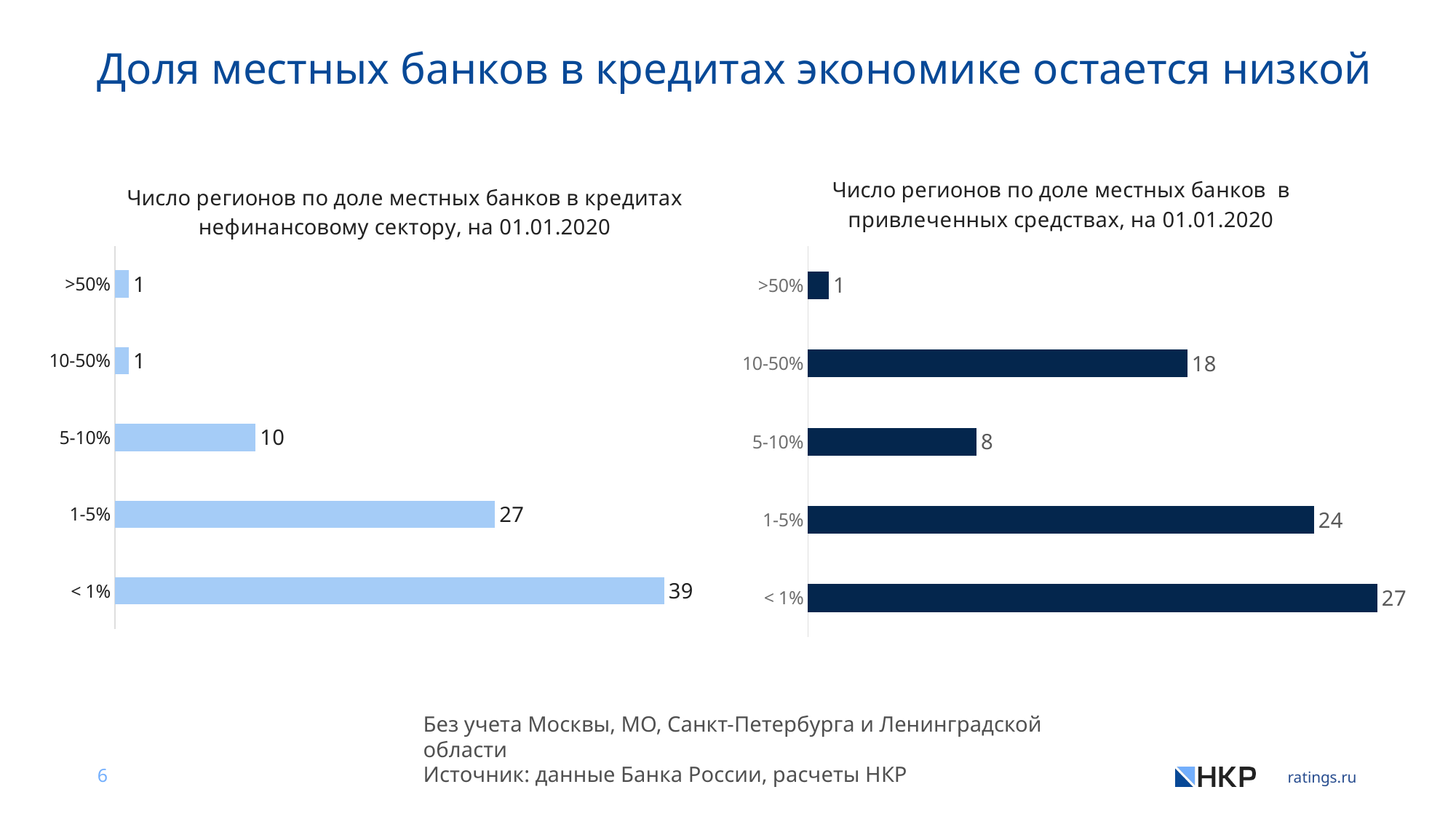
In the right chart (attracted funds), which is larger: '10-50%' or '5-10%'? 10-50% In the left chart (credits to the non-financial sector), what is the total number of regions across all categories? 78 How many categories are shown in the left chart (credits to the non-financial sector)? 5 Which is larger: the '5-10%' value in the left chart or the '5-10%' value in the right chart? Left chart (10) In the left chart (credits to the non-financial sector), which category has the highest number of regions? < 1% What is the title of the right chart? Число регионов по доле местных банков в привлеченных средствах, на 01.01.2020 In the left chart (credits to the non-financial sector), how many regions fall in the '< 1%' category? 39 In the left chart (credits to the non-financial sector), what is the difference between the '< 1%' and '1-5%' categories? 12 What type of chart is used on the right side of the slide? Bar chart In the right chart (attracted funds), how many regions fall in the '10-50%' category? 18 In the right chart (attracted funds), what is the difference between the '1-5%' and '5-10%' categories? 16 In the right chart (attracted funds), which category has the lowest number of regions? >50%